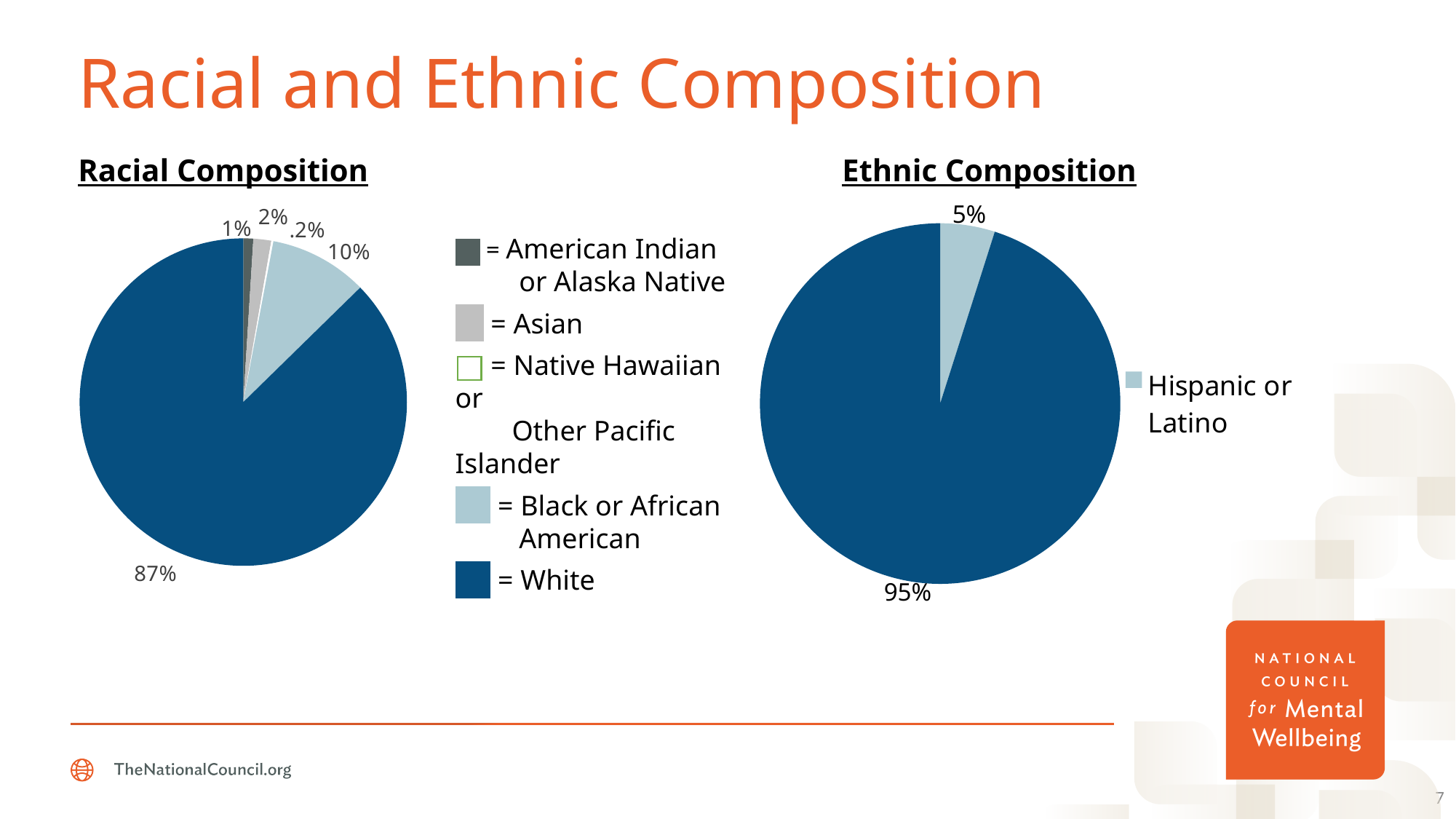
In the Racial Composition chart, how many categories does the legend list? 5 In the Racial Composition chart, what share is American Indian or Alaska Native? 1% In the Racial Composition chart, which category has the smallest share? Native Hawaiian or Other Pacific Islander In the Racial Composition chart, which category has the largest share? White In the Racial Composition chart, what is the difference between the White share and the Black or African American share? 77% In the Ethnic Composition chart, what share is Hispanic or Latino? 5% In the Racial Composition chart, what share is Native Hawaiian or Other Pacific Islander? .2% What kind of chart is the Racial Composition chart? pie chart In the Racial Composition chart, what share is Black or African American? 10% In the Racial Composition chart, what share is White? 87% In the Racial Composition chart, what share is Asian? 2% In the Ethnic Composition chart, which is larger: the 95% slice or the Hispanic or Latino slice? the 95% slice